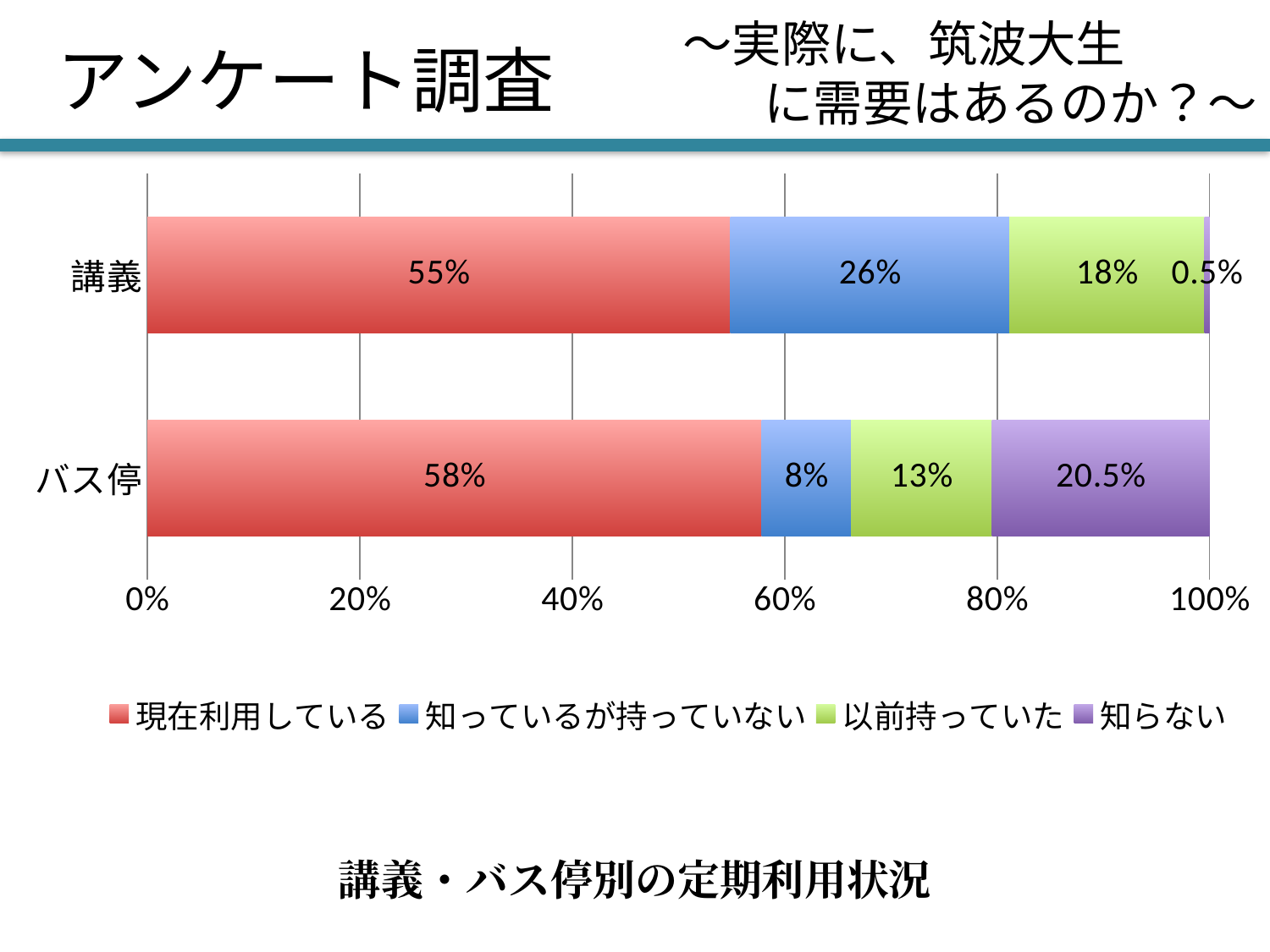
What is the difference between the 現在利用している values for バス停 and 講義? 3% How many categories are plotted on the chart? 2 Which legend entry is shown in purple? 知らない What is the value of 現在利用している for 講義? 55% What is the value of 知らない for バス停? 20.5% Which category has the higher value for 知っているが持っていない, 講義 or バス停? 講義 What is the value of 知らない for 講義? 0.5% How many series does the legend list? 4 What is the difference between the 知らない values for バス停 and 講義? 20% What is the value of 知っているが持っていない for バス停? 8% What type of chart is shown on the slide? stacked bar chart What is the value of 以前持っていた for バス停? 13%